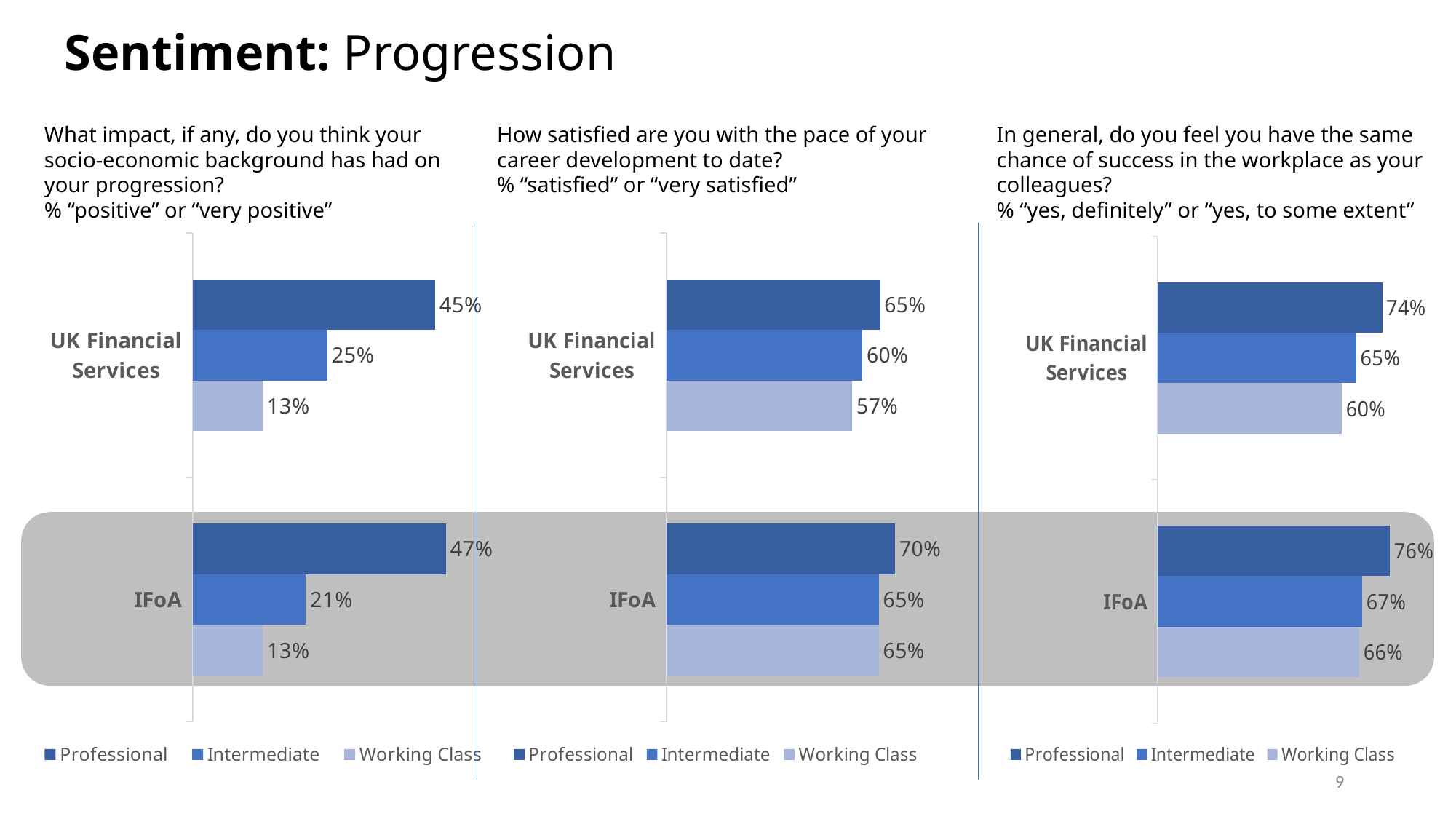
In the middle chart (satisfaction with pace of career development), what is the value for Intermediate in UK Financial Services? 60% In the right chart (same chance of success in the workplace), what is the difference between Professional for IFoA and Professional for UK Financial Services? 2% In the left chart (impact of socio-economic background on progression), what is the value for Working Class in IFoA? 13% How many series does the legend of the left chart list? 3 In the right chart (same chance of success in the workplace), which series has the lowest value for UK Financial Services? Working Class How many categories are shown on the y axis of the middle chart? 2 In the middle chart (satisfaction with pace of career development), which is larger: Working Class for IFoA or Working Class for UK Financial Services? Working Class for IFoA In the middle chart (satisfaction with pace of career development), which series has the highest value for IFoA? Professional In the left chart (impact of socio-economic background on progression), what is the value for Professional in UK Financial Services? 45% In the left chart (impact of socio-economic background on progression), what is the difference between Professional and Working Class for UK Financial Services? 32% In the right chart (same chance of success in the workplace), what is the value for Professional in IFoA? 76% What kind of chart is the right chart (same chance of success in the workplace)? Bar chart